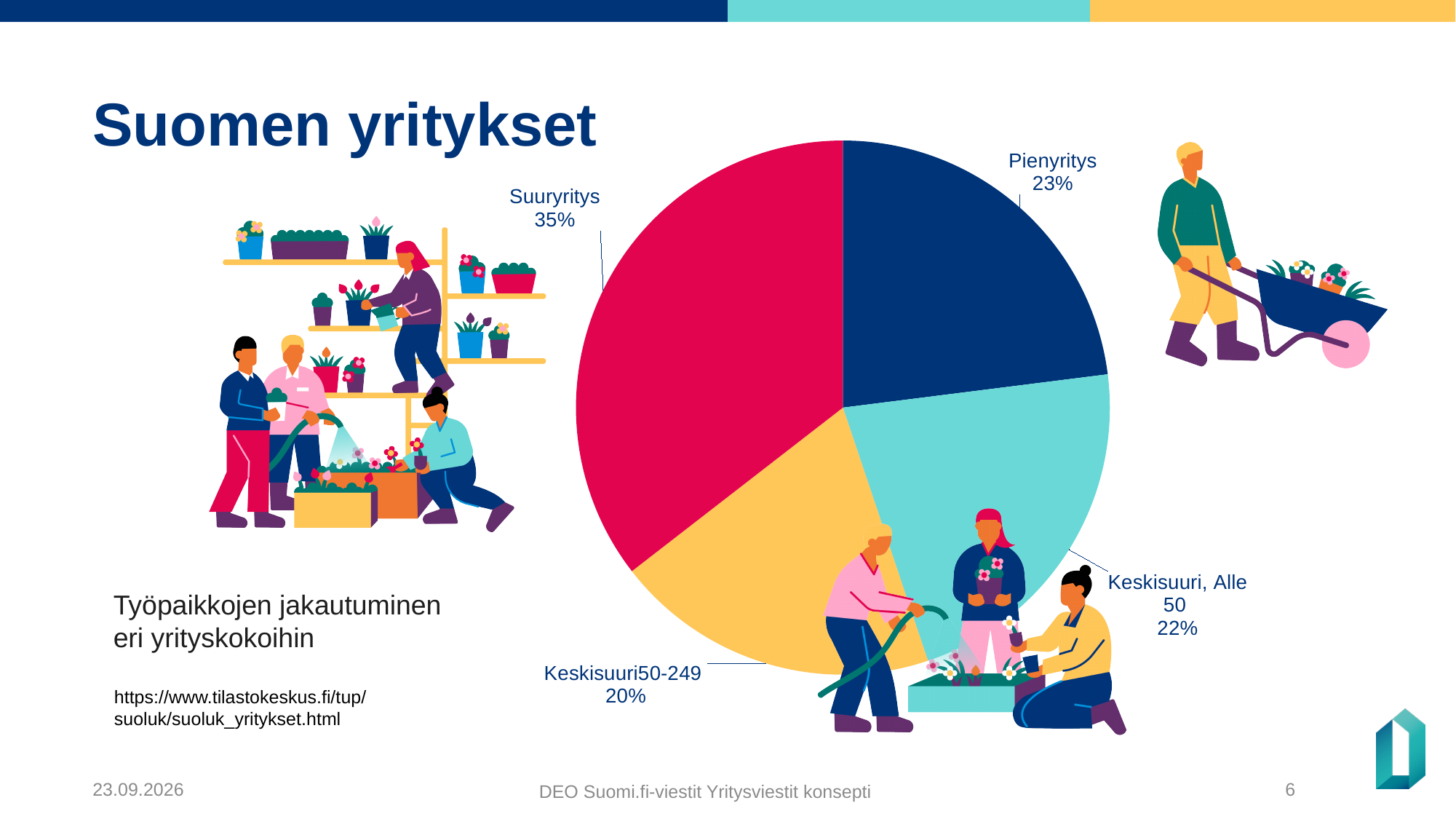
What share of the pie does Suuryritys have? 35% Which slice of the pie is the smallest? Keskisuuri50-249 What share of the pie does Keskisuuri50-249 have? 20% What share of the pie does Keskisuuri, Alle 50 have? 22% What is the difference in percentage points between Suuryritys and Pienyritys? 12 Which slice of the pie is the largest? Suuryritys What is the combined share of the two Keskisuuri slices (Alle 50 and 50-249)? 42% What share of the pie does Pienyritys have? 23% How many slices does the pie chart have? 4 What kind of chart is shown on the slide? pie chart Which is larger, the share for Pienyritys or the share for Keskisuuri50-249? Pienyritys What colour is the Suuryritys slice of the pie? red